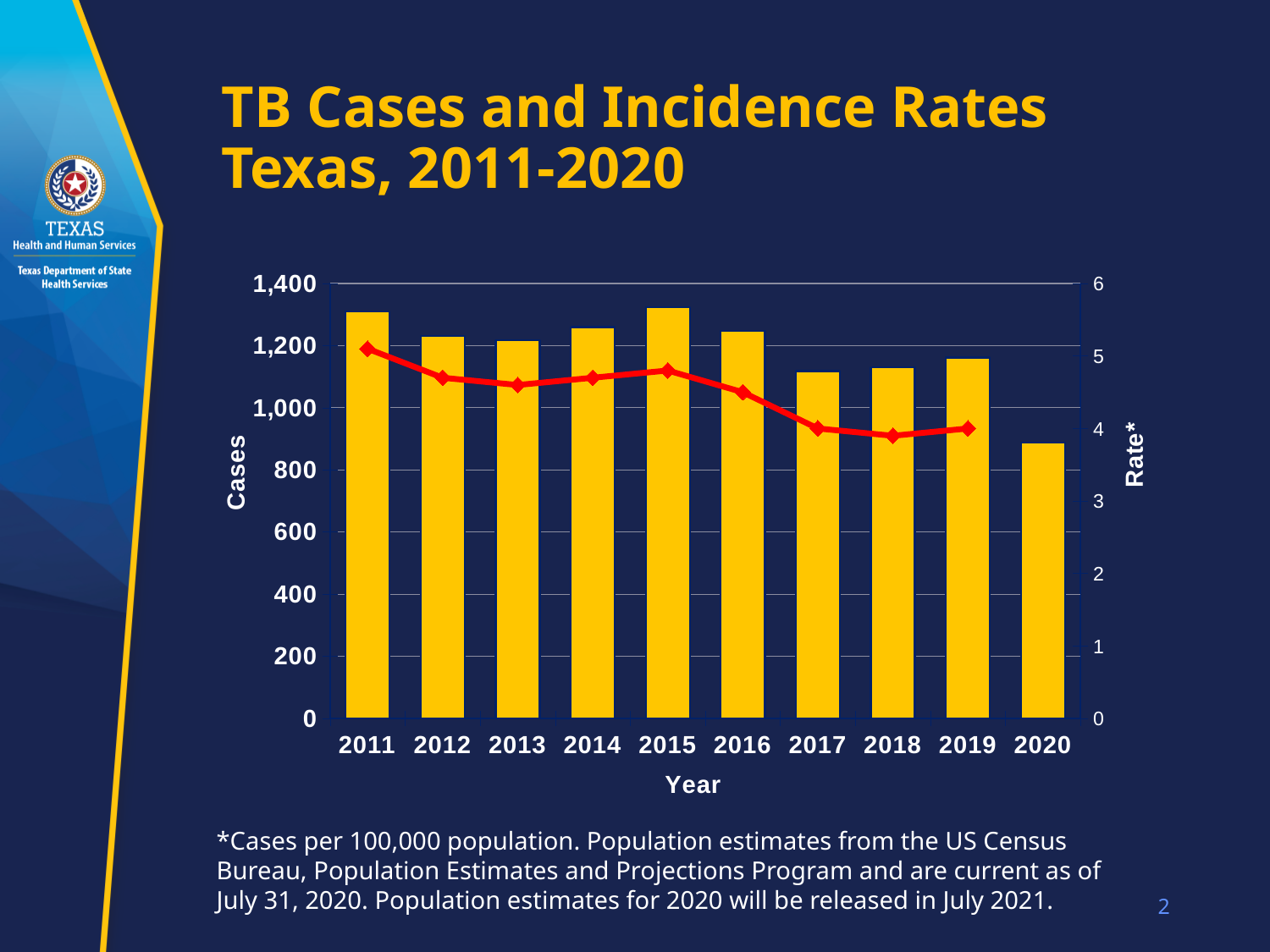
How many years are shown on the x axis of the chart? 10 What is the label of the left vertical axis? Cases Do the TB case counts rise or fall from 2015 to 2020? fall Which year has the lowest number of TB cases? 2020 Is the number of cases for 2020 greater or less than 1,000? less Is the number of cases for 2011 greater or less than 1,200? greater Which year has the highest incidence rate on the red line? 2011 Which year has more TB cases, 2019 or 2020? 2019 What kind of chart is shown on the slide? A bar chart with a line overlay Is the number of cases for 2017 greater or less than 1,200? less